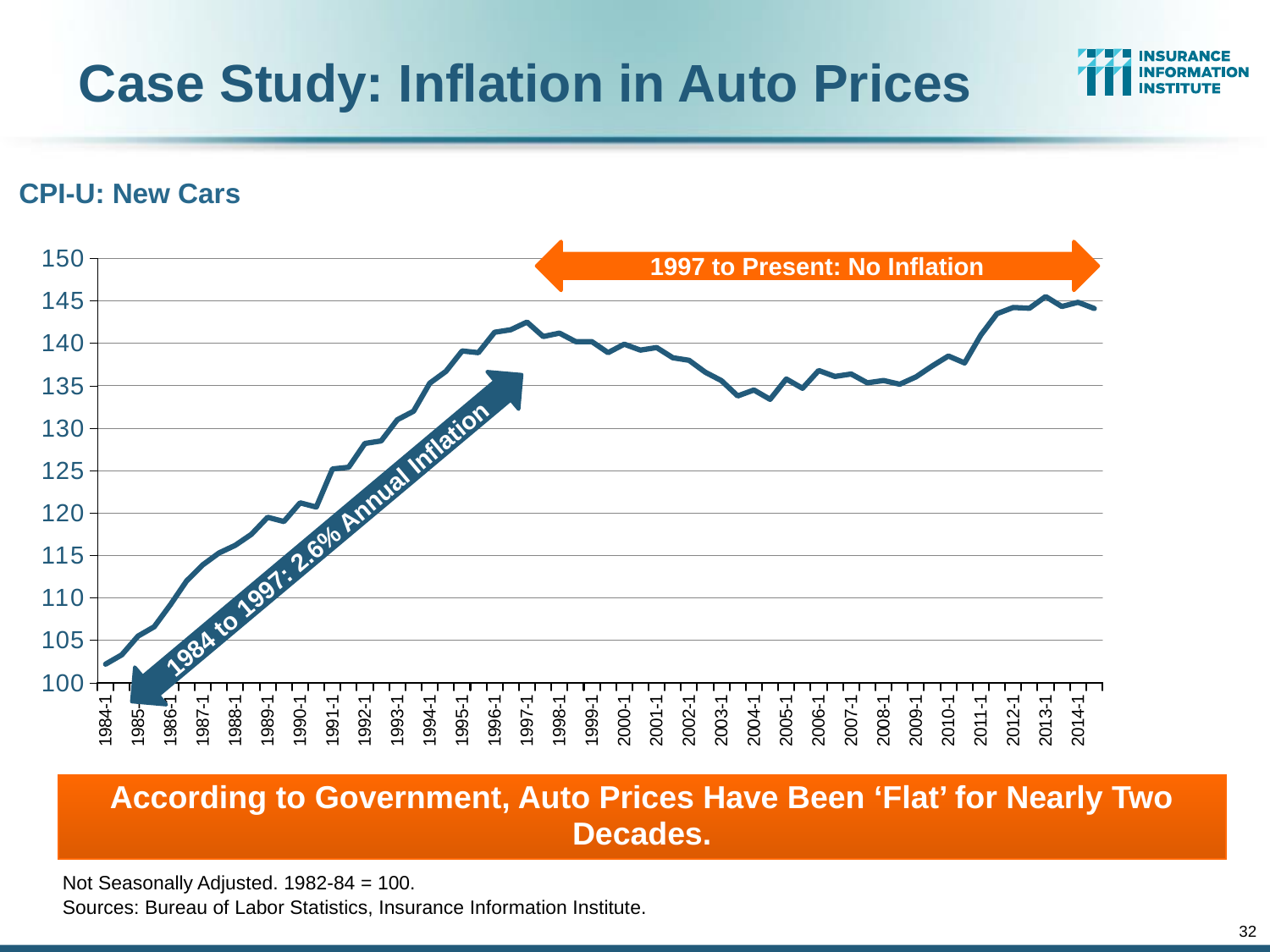
Is the value for 1984-1 greater or less than 105? less Which x-axis label has the lowest value on the chart? 1984-1 Is the value for 2009-1 greater or less than 140? less What kind of chart is shown on the slide? line chart How many year labels are shown on the x axis? 31 Is the value for 2004-1 greater or less than 140? less According to the annotation on the chart, what was the annual inflation rate from 1984 to 1997? 2.6% What is the title of the chart? CPI-U: New Cars Do the values rise or fall along the x axis from 1984-1 to 1997-1? rise